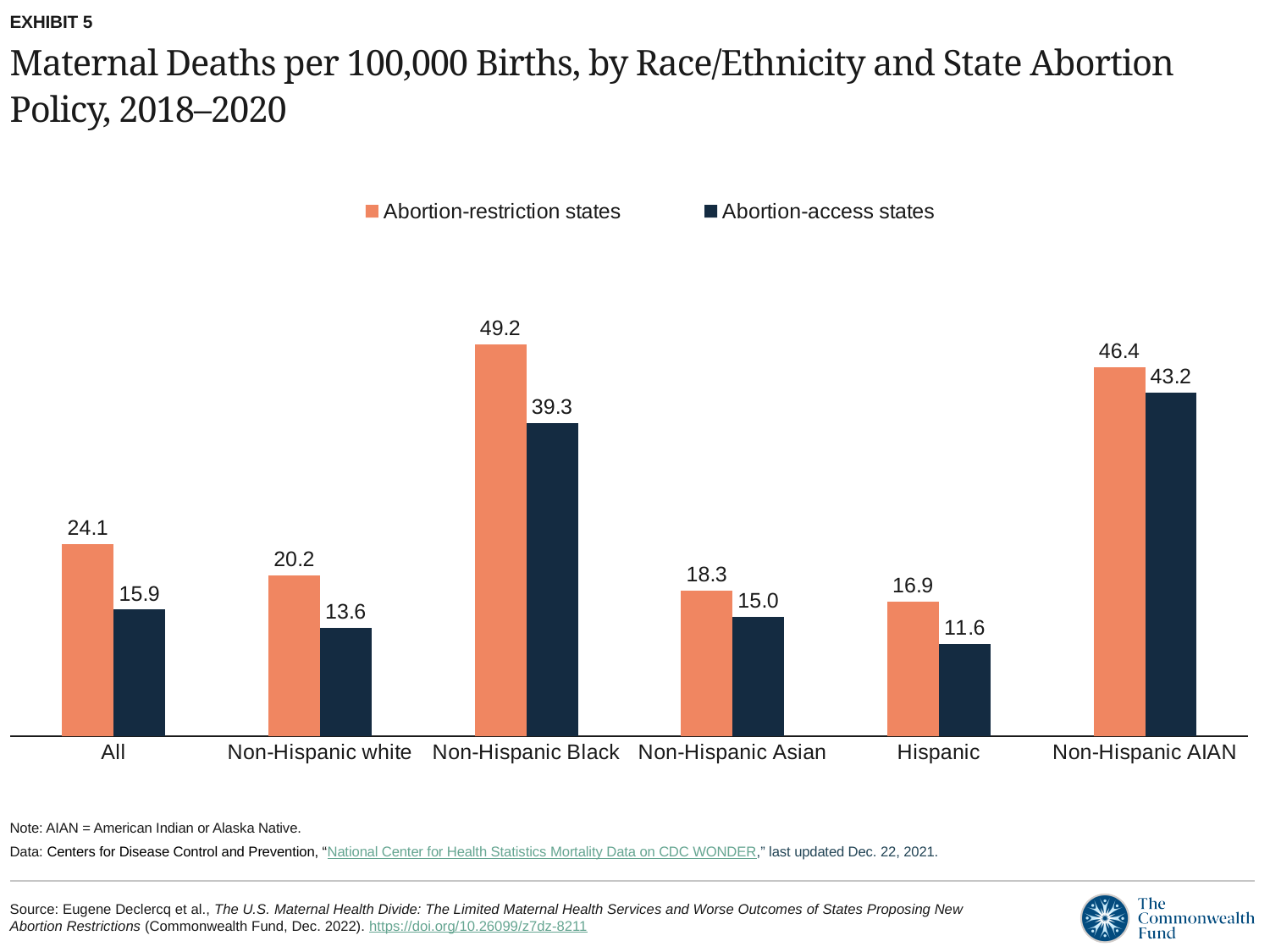
Which race/ethnicity category has the lowest maternal death rate in abortion-access states? Hispanic What is the value for Non-Hispanic AIAN in abortion-access states? 43.2 Which race/ethnicity category has the highest maternal death rate in abortion-restriction states? Non-Hispanic Black What is the difference between the abortion-restriction and abortion-access values for All? 8.2 How many series does the legend list? 2 How many race/ethnicity categories are shown on the x axis? 6 What is the difference between the abortion-restriction and abortion-access values for Non-Hispanic Black? 9.9 What kind of chart is shown on the slide? Bar chart What is the maternal death rate for Non-Hispanic Black in abortion-restriction states? 49.2 Which colour represents abortion-access states in the chart? Dark navy blue Which is larger for Non-Hispanic Asian: the abortion-restriction states value or the abortion-access states value? Abortion-restriction states What is the maternal death rate for Hispanic in abortion-access states? 11.6